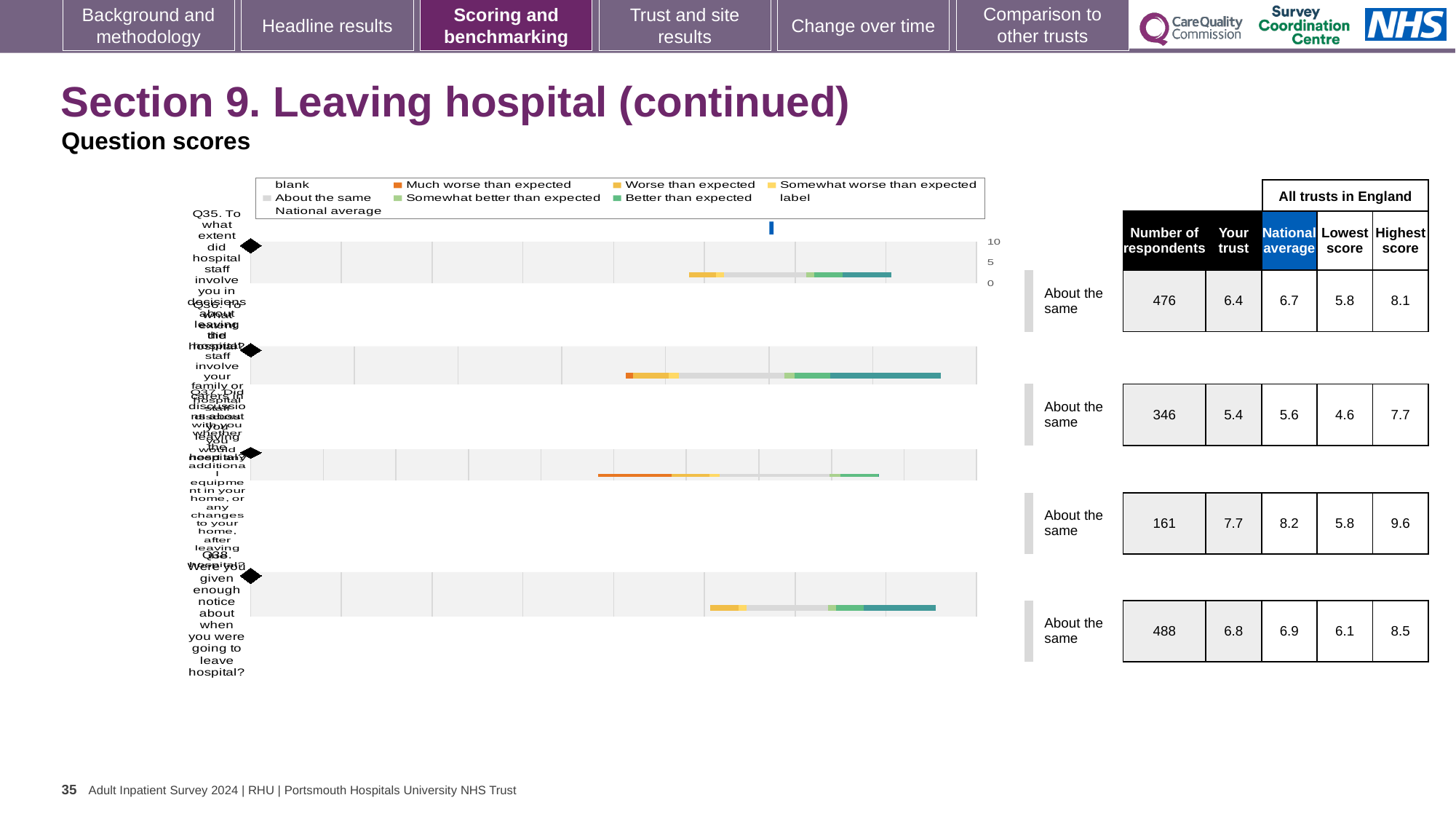
What benchmark category label is shown to the right of the Q35 row of the chart? About the same How many entries does the chart legend list? 9 For the last row (Q38), which is larger: the 'Your trust' score or the national average? National average In the table beside the chart, what is the 'Your trust' score for the first row (Q35)? 6.4 Which row of the table has the lowest number of respondents? The third row (161) For the first row (Q35), what is the difference between the highest score and the lowest score in the table? 2.3 In the table beside the chart, what is the national average for the last row (Q38)? 6.9 How many question rows (diamond markers) are plotted in the chart? 4 Which row of the table has the highest 'Your trust' score? The third row (7.7) In the table beside the chart, how many respondents are listed for the last row (Q38)? 488 Which legend entry is shown in dark orange? Much worse than expected What kind of chart is used to show the question scores on this slide? bar chart